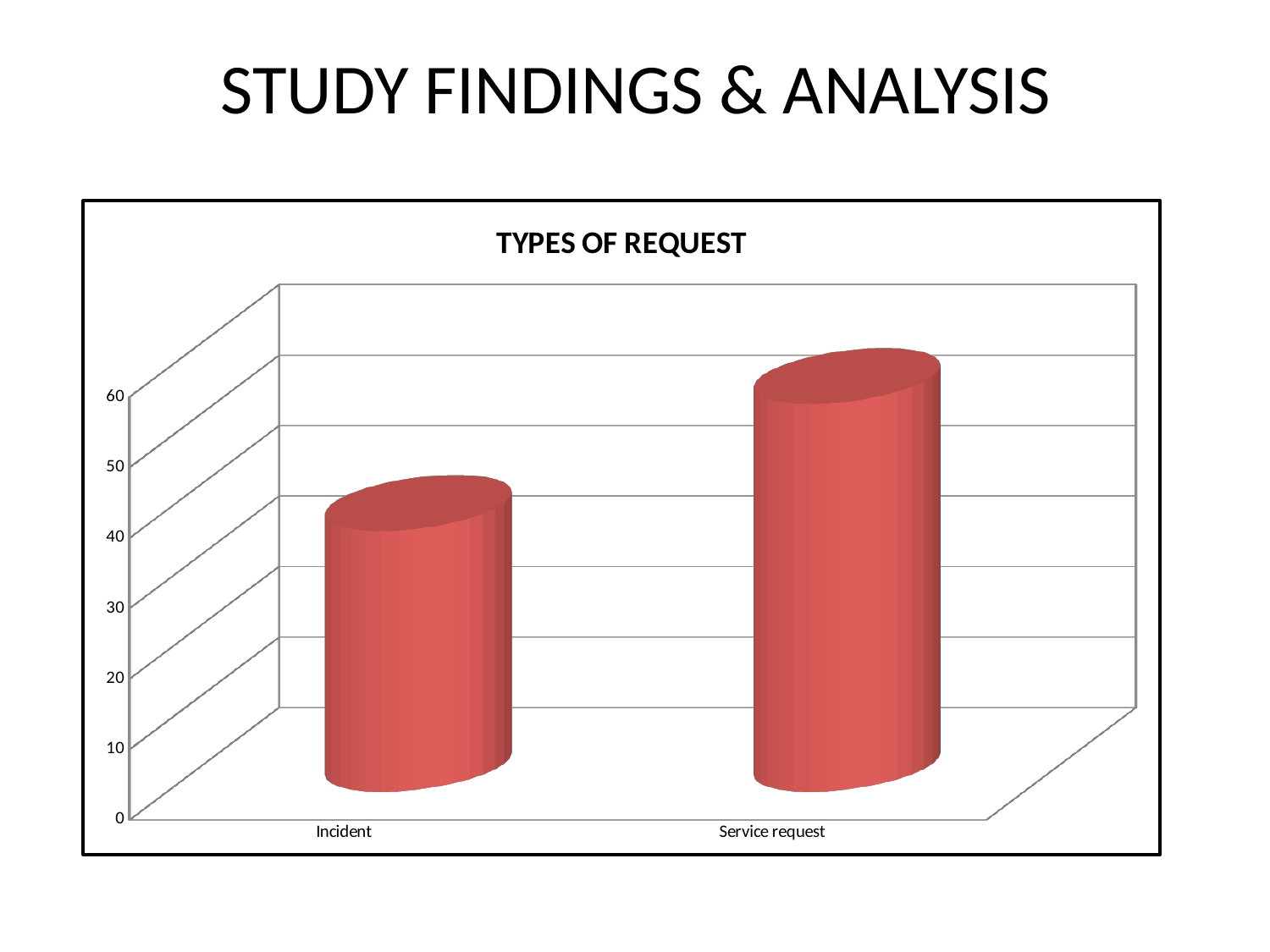
What is the highest tick value shown on the vertical axis of the chart? 60 What kind of chart is shown on the slide? bar chart Is the value for Incident greater or less than 50? less Which category has the lowest value in the chart? Incident Is the value for Service request greater or less than 30? greater Do the values rise or fall from Incident to Service request along the x axis? rise Which is larger, the value for Incident or the value for Service request? Service request What is the title of the chart? TYPES OF REQUEST Which category has the highest value in the chart? Service request Is the value for Incident greater or less than 20? greater How many categories are shown on the x axis of the chart? 2